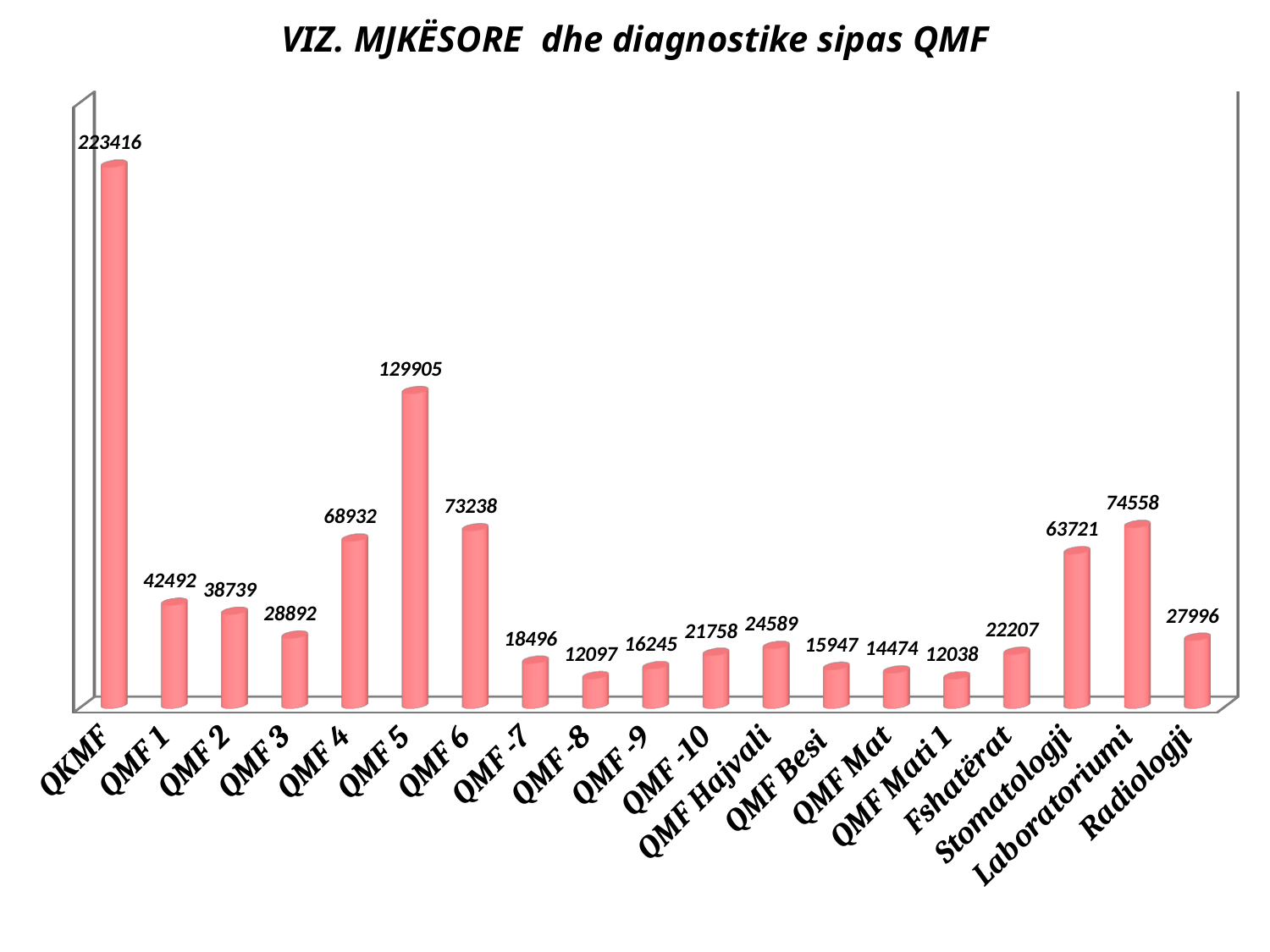
What kind of chart is shown on the slide? Bar chart What is the value for QMF Hajvali? 24589 What is the value for QKMF? 223416 What is the value for Laboratoriumi? 74558 What is the value for QMF 5? 129905 How many categories are shown on the x axis? 19 What is the title of the chart? VIZ. MJKËSORE dhe diagnostike sipas QMF What is the difference between the values for QKMF and QMF 5? 93511 What is the difference between the values for Laboratoriumi and Stomatologji? 10837 Which category has the lowest value? QMF Mati 1 Which is larger, the value for QMF 6 or the value for QMF 4? QMF 6 Which category has the highest value? QKMF